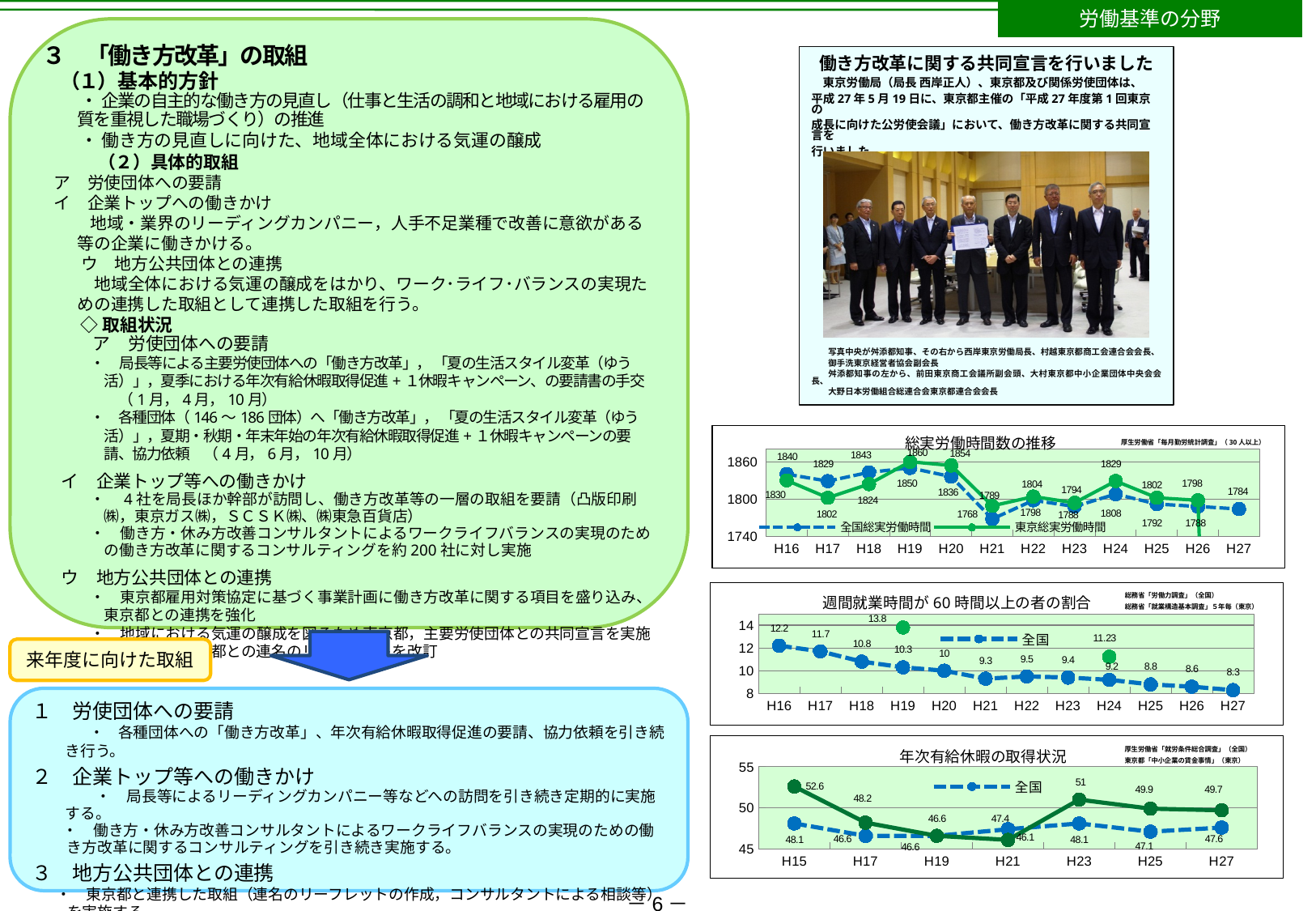
In the chart titled 週間就業時間が60時間以上の者の割合, what is the 全国 value for H27? 8.3 In the chart titled 週間就業時間が60時間以上の者の割合, what is the 全国 value for H16? 12.2 In the chart titled 総実労働時間数の推移, what is the lowest value labelled for the 東京総実労働時間 series? 1789 In the chart titled 年次有給休暇の取得状況, what is the highest value labelled on the green (Tokyo) line? 52.6 In the chart titled 年次有給休暇の取得状況, which is larger at H23: the green line value or the 全国 value? the green line value (51) In the chart titled 週間就業時間が60時間以上の者の割合, what is the difference between the 全国 values for H16 and H27? 3.9 In the chart titled 総実労働時間数の推移, how many years are plotted along the x axis? 12 In the chart titled 総実労働時間数の推移, how many series does the legend list? 2 In the chart titled 週間就業時間が60時間以上の者の割合, does the 全国 series generally rise or fall from H16 to H27? fall In the chart titled 週間就業時間が60時間以上の者の割合, what is the value of the green point at H19? 13.8 In the chart titled 年次有給休暇の取得状況, what is the 全国 value for H15? 48.1 What kind of chart is the chart titled 年次有給休暇の取得状況? line chart